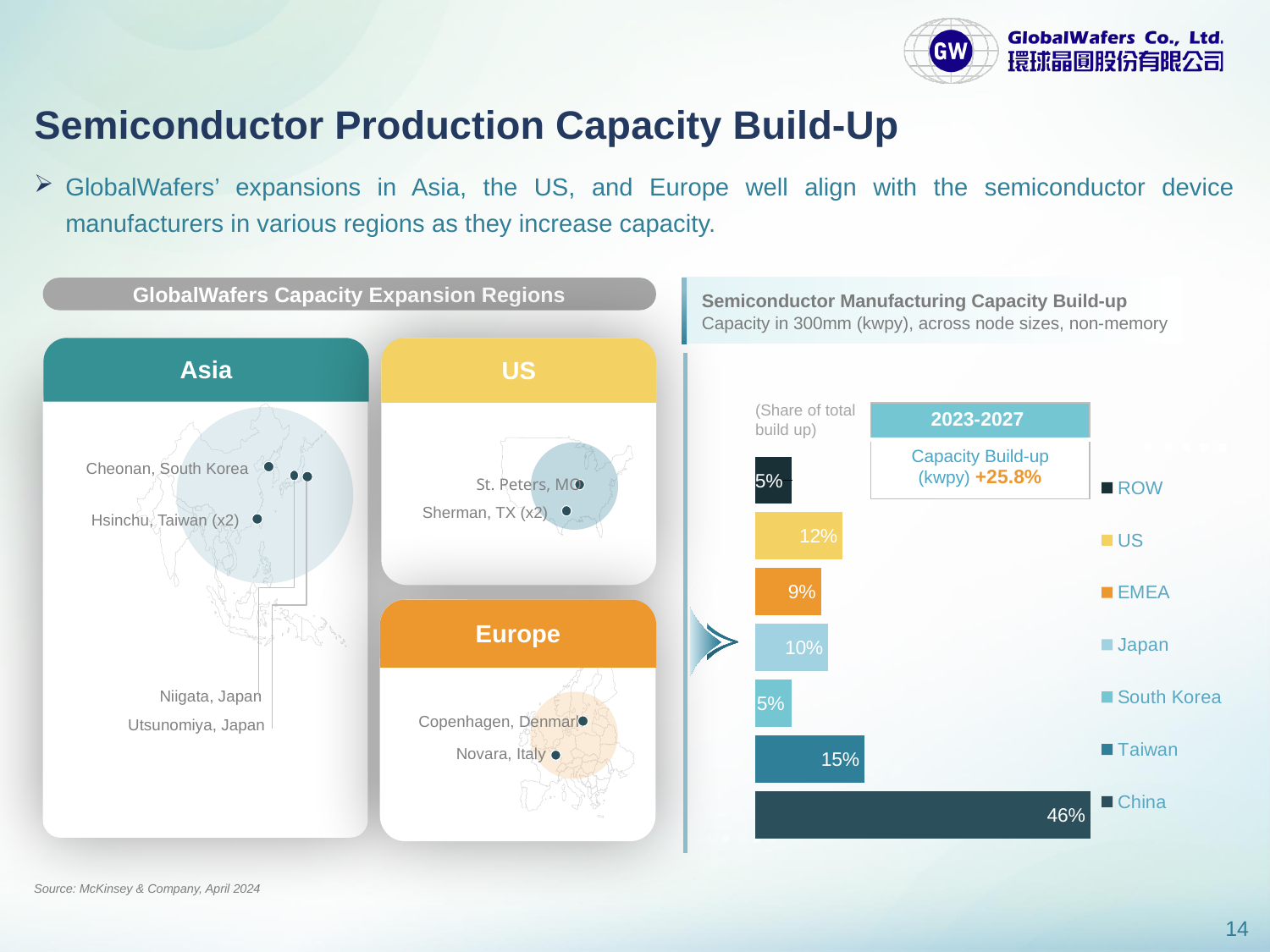
What period does the capacity build-up chart cover? 2023-2027 What is the difference in share between China and Taiwan? 31% What type of chart is used to show the semiconductor manufacturing capacity build-up? Bar chart What share of the total build-up is attributed to EMEA? 9% What is the total capacity build-up (kwpy) shown for 2023-2027? +25.8% What share of the total build-up is attributed to Taiwan? 15% How many regions are listed in the chart's legend? 7 Which region has the largest share of the capacity build-up? China What share of the total build-up is attributed to the US? 12% Which has a larger share of the build-up, the US or EMEA? US What share of the total build-up is attributed to Japan? 10% What share of the total semiconductor manufacturing capacity build-up is attributed to China? 46%